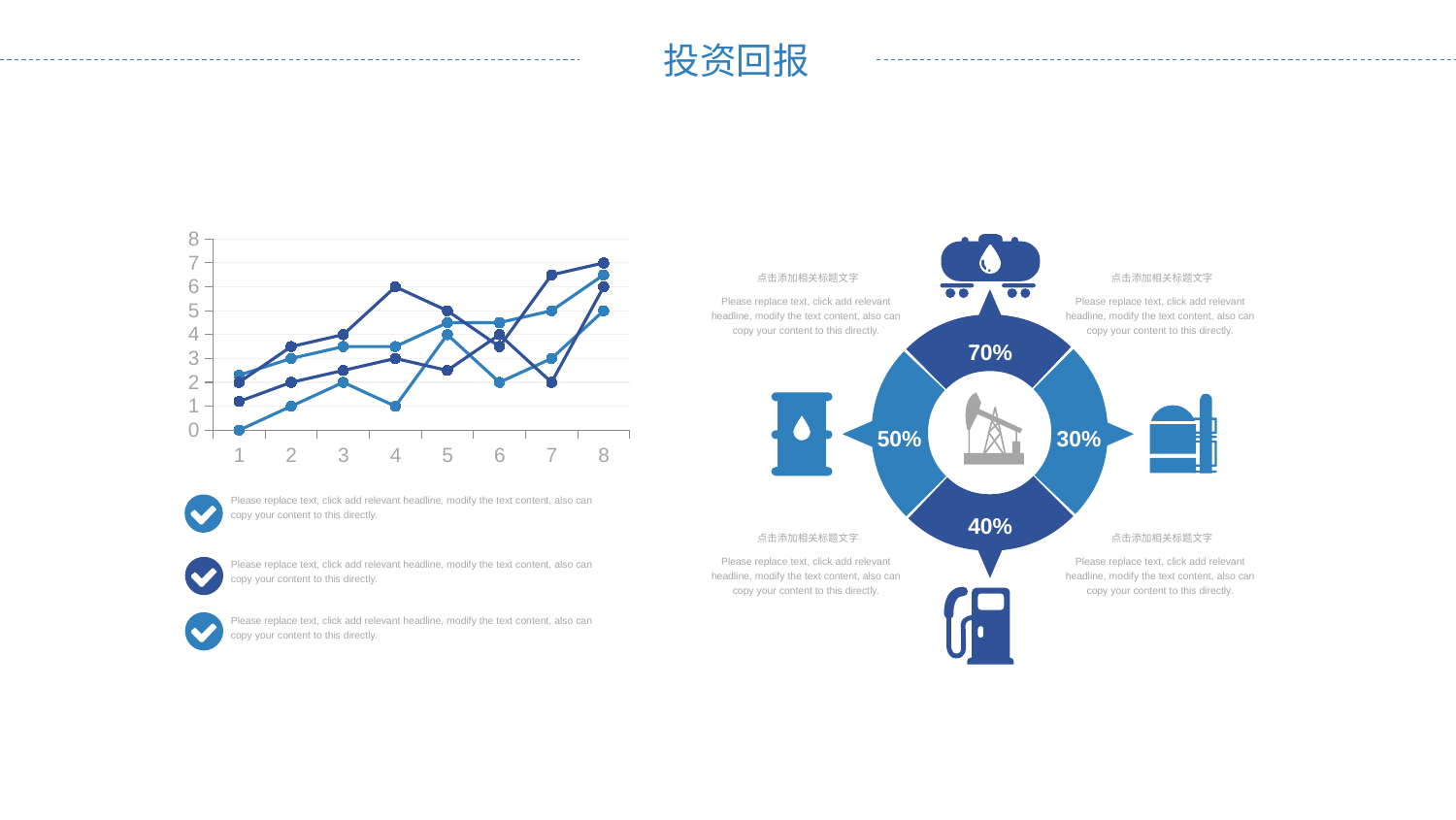
In the line chart, is the highest value at x = 8 greater or less than 6? greater In the line chart, is the lowest value at x = 1 greater or less than 1? less At which x-axis point does the line chart have its overall lowest value? 1 Does the line chart on the slide include a legend? No How many points are there along the x axis of the line chart? 8 Do the values in the line chart generally rise or fall from x = 1 to x = 8? rise What kind of chart is shown on the left side of the slide? line chart In the line chart, is the lowest value at x = 4 greater or less than 2? less At which x-axis point does the line chart reach its overall highest value? 8 How many lines (series) are plotted in the line chart? 4 What is the highest value shown on the y axis of the line chart? 8